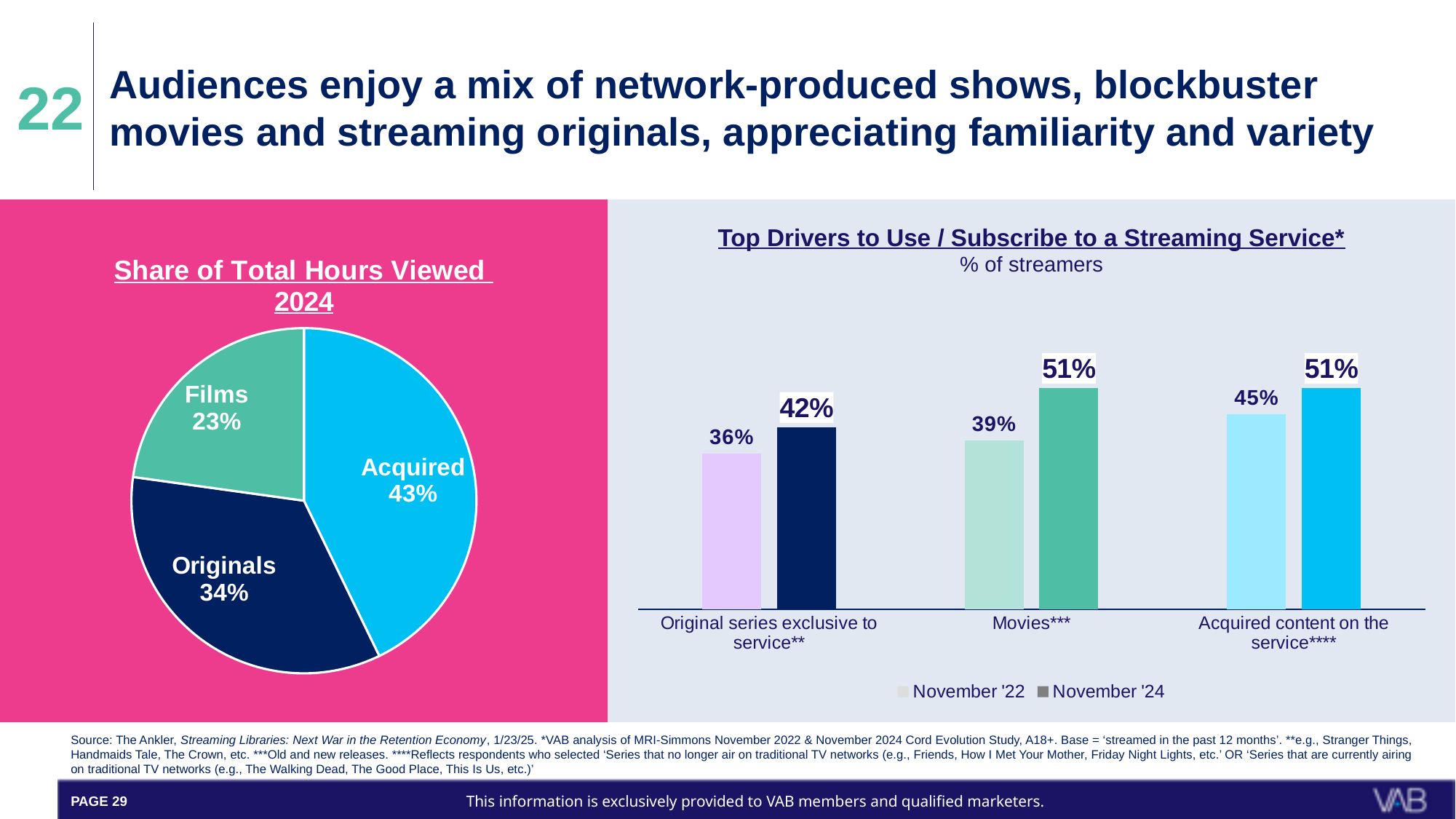
What kind of chart is 'Share of Total Hours Viewed 2024'? Pie chart In the 'Top Drivers to Use / Subscribe to a Streaming Service' chart, how many series does the legend list? 2 In the 'Share of Total Hours Viewed 2024' pie chart, which category has the smallest share? Films In the 'Top Drivers to Use / Subscribe to a Streaming Service' chart, what is the November '22 value for Original series exclusive to service? 36% In the 'Top Drivers to Use / Subscribe to a Streaming Service' chart, what is the November '24 value for Movies? 51% What kind of chart is 'Top Drivers to Use / Subscribe to a Streaming Service'? Bar chart In the 'Top Drivers to Use / Subscribe to a Streaming Service' chart, which category has the lowest November '24 value? Original series exclusive to service In the 'Share of Total Hours Viewed 2024' pie chart, what is the difference between the Acquired and Originals shares? 9% In the 'Share of Total Hours Viewed 2024' pie chart, what share do Films account for? 23% In the 'Top Drivers to Use / Subscribe to a Streaming Service' chart, by how much did the value for Movies increase from November '22 to November '24? 12% In the 'Share of Total Hours Viewed 2024' pie chart, how many slices are there? 3 In the 'Share of Total Hours Viewed 2024' pie chart, which category has the largest share? Acquired